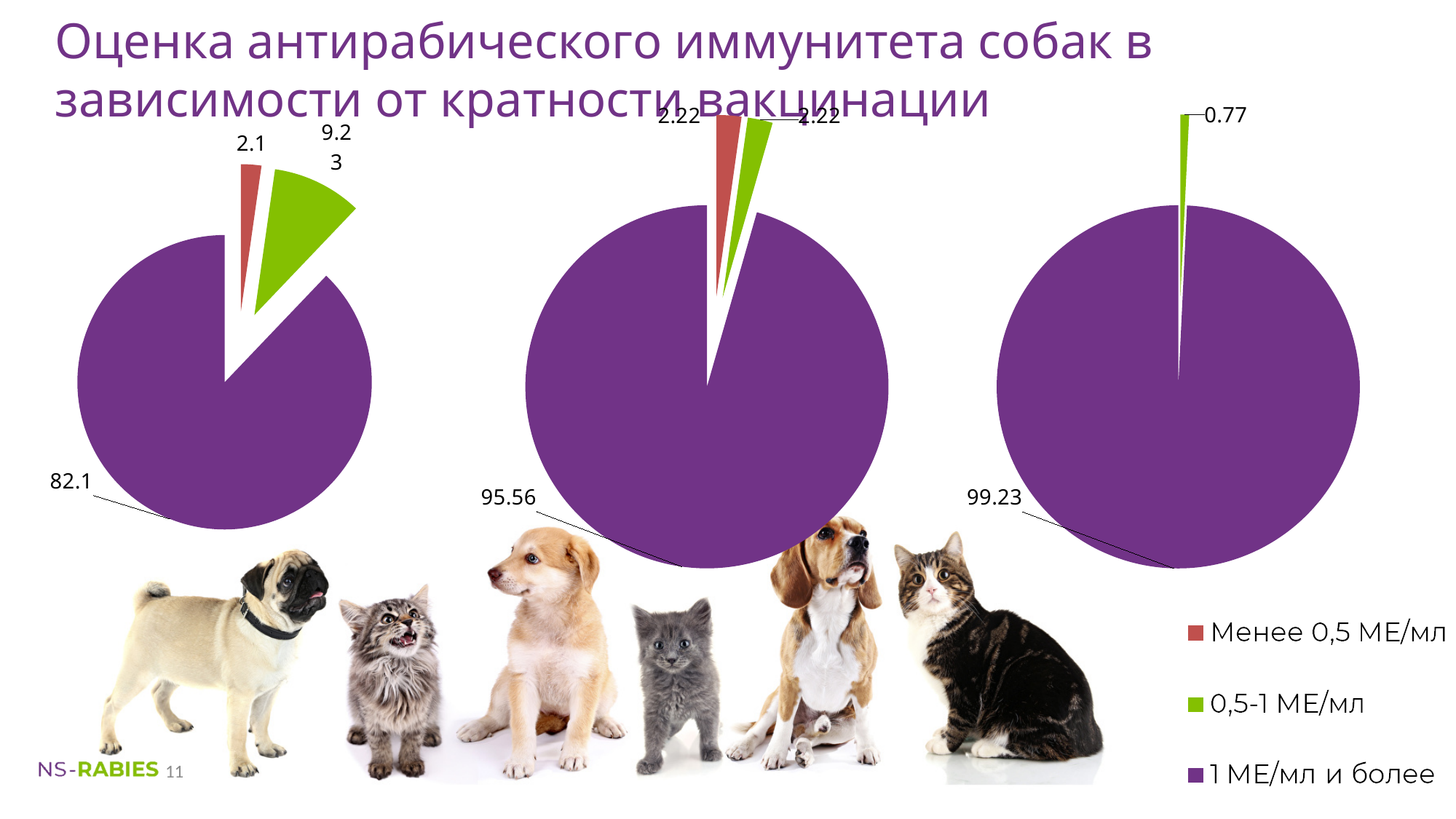
In the left pie chart, what value is shown for the 'Менее 0,5 МЕ/мл' slice? 2.1 How many entries does the legend list? 3 In the left pie chart, what is the difference between the '0,5-1 МЕ/мл' value and the 'Менее 0,5 МЕ/мл' value? 7.13 In the left pie chart, which category has the largest slice? 1 МЕ/мл и более In the left pie chart, what value is shown for the '0,5-1 МЕ/мл' slice? 9.23 In the middle pie chart, what value is shown for the '1 МЕ/мл и более' slice? 95.56 In the middle pie chart, what value is shown for the 'Менее 0,5 МЕ/мл' slice? 2.22 In the right pie chart, what value is shown for the '1 МЕ/мл и более' slice? 99.23 In the right pie chart, what value is shown for the '0,5-1 МЕ/мл' slice? 0.77 In the left pie chart, what value is shown for the '1 МЕ/мл и более' slice? 82.1 In the left pie chart, which category has the smallest slice? Менее 0,5 МЕ/мл Which is larger: the '1 МЕ/мл и более' value in the middle pie chart or in the right pie chart? Right pie chart